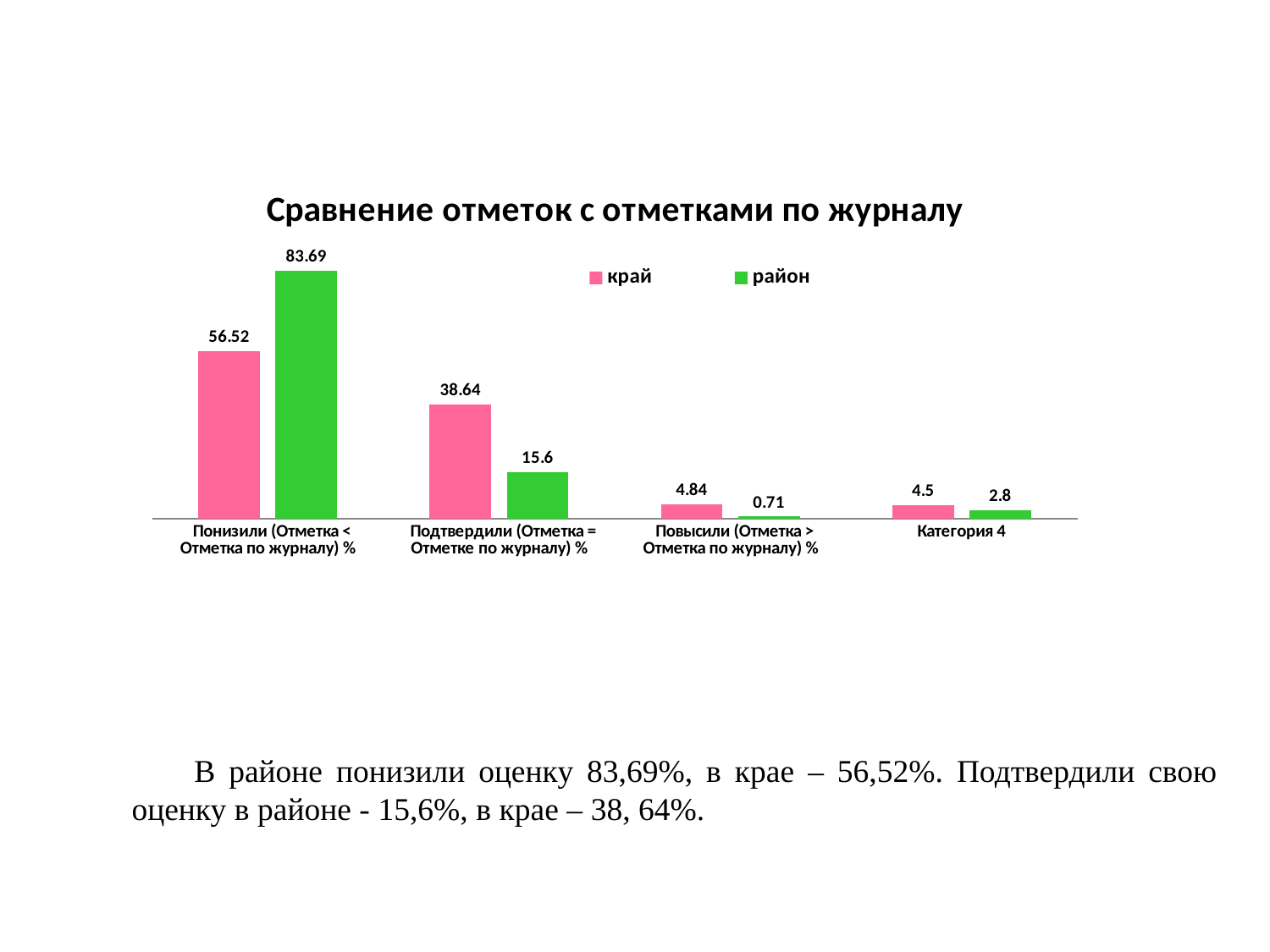
Which category has the lowest value for the "край" series? Категория 4 What is the value for "край" in the "Категория 4" category? 4.5 How many series does the legend list? 2 What is the value for "край" in the "Подтвердили (Отметка = Отметке по журналу) %" category? 38.64 What is the value for "район" in the "Понизили (Отметка < Отметка по журналу) %" category? 83.69 Which category has the highest value for the "район" series? Понизили (Отметка < Отметка по журналу) % What kind of chart is shown on the slide? Bar chart What is the difference between the "район" and "край" values in the "Понизили (Отметка < Отметка по журналу) %" category? 27.17 What is the title of the chart? Сравнение отметок с отметками по журналу How many categories are shown on the x axis? 4 Which is larger in the "Подтвердили (Отметка = Отметке по журналу) %" category: "край" or "район"? край What is the value for "район" in the "Повысили (Отметка > Отметка по журналу) %" category? 0.71